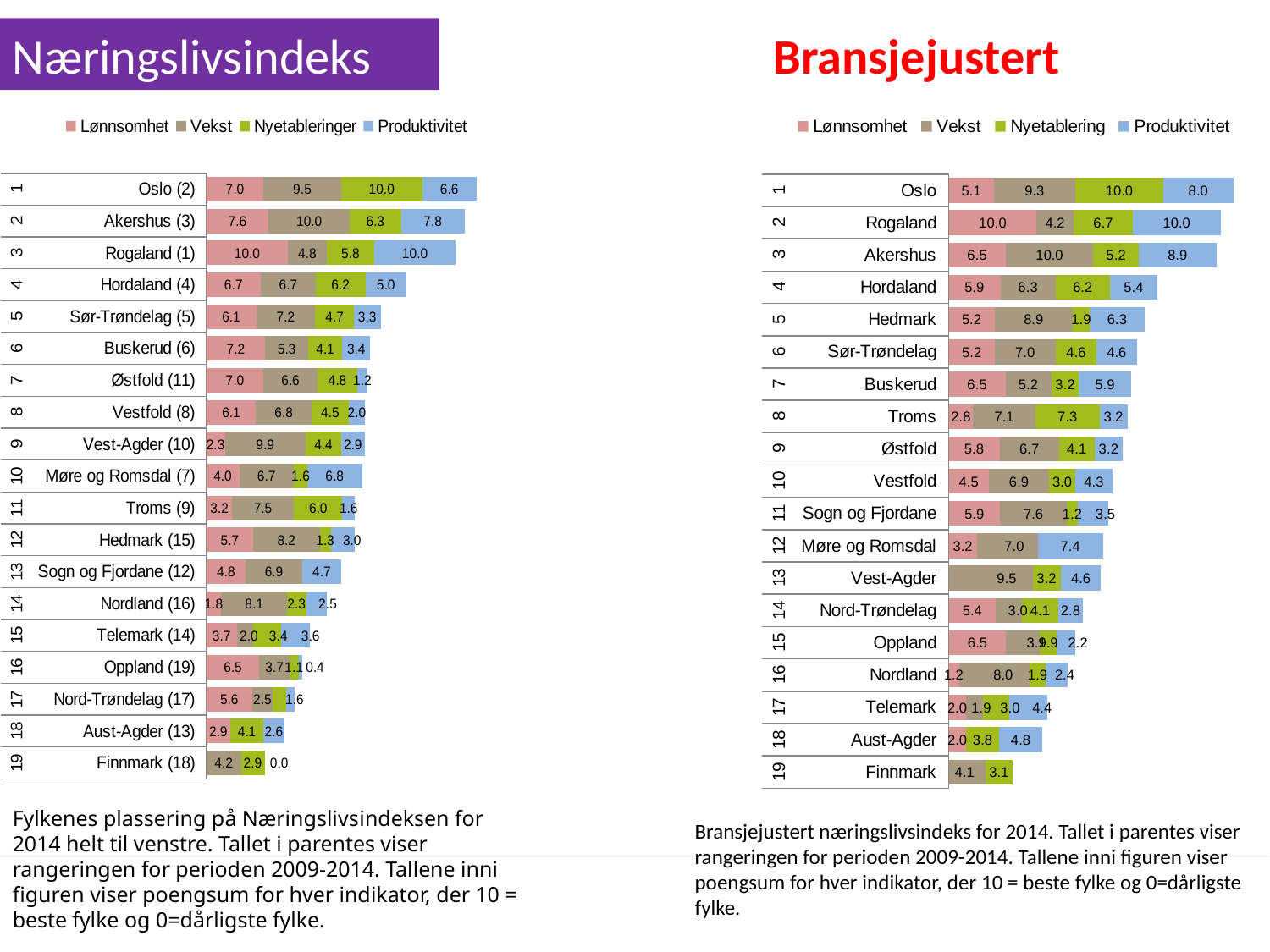
In the Bransjejustert chart, what is the total of the stacked bar for Oslo? 32.4 How many counties are listed in the Næringslivsindeks chart? 19 In the Næringslivsindeks chart, what is the Vekst value for Oslo (2)? 9.5 In the Bransjejustert chart, which county is ranked first (has the longest total bar)? Oslo In the Bransjejustert chart, what is the Produktivitet value for Hedmark? 6.3 How many series does the legend of the Bransjejustert chart list? 4 In the Næringslivsindeks chart, what is the Produktivitet value for Akershus (3)? 7.8 In the Næringslivsindeks chart, what is the total of the stacked bar for Oslo (2)? 33.1 In the Næringslivsindeks chart, what is the difference between the Vekst and Nyetableringer values for Akershus (3)? 3.7 What type of chart is the Næringslivsindeks chart on the left? Stacked bar chart In the Næringslivsindeks chart, which is larger for Rogaland (1): Lønnsomhet or Vekst? Lønnsomhet In the Bransjejustert chart, what is the Lønnsomhet value for Rogaland? 10.0